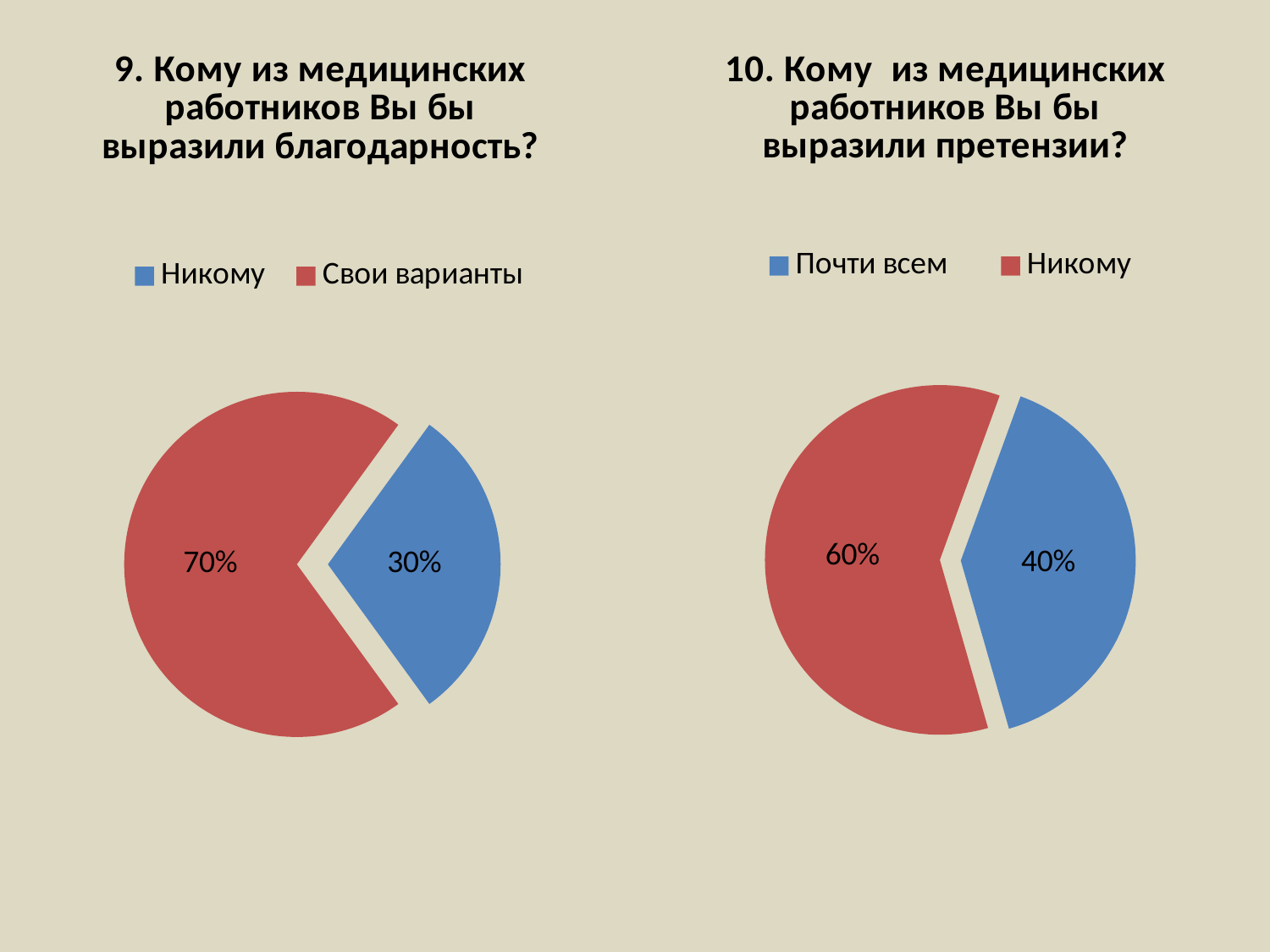
In the right chart (question 10, about expressing complaints), what share is labelled for 'Никому'? 60% In the left chart (question 9), what is the difference between the 'Свои варианты' and 'Никому' shares? 40% In the right chart (question 10), what is the difference between the 'Никому' and 'Почти всем' shares? 20% In the right chart (question 10, about expressing complaints), what share is labelled for 'Почти всем'? 40% In the left chart (question 9), what colour is the 'Никому' slice? Blue How many categories does the legend of the right chart (question 10) list? 2 In the left chart (question 9, about expressing gratitude), what share is labelled for 'Никому'? 30% In the left chart (question 9), which category has the largest slice? Свои варианты What type of chart is used on the left side of the slide (question 9)? Pie chart In the right chart (question 10), which is larger: 'Почти всем' or 'Никому'? Никому In the left chart (question 9, about expressing gratitude), what share is labelled for 'Свои варианты'? 70% In the right chart (question 10), which category has the smallest slice? Почти всем